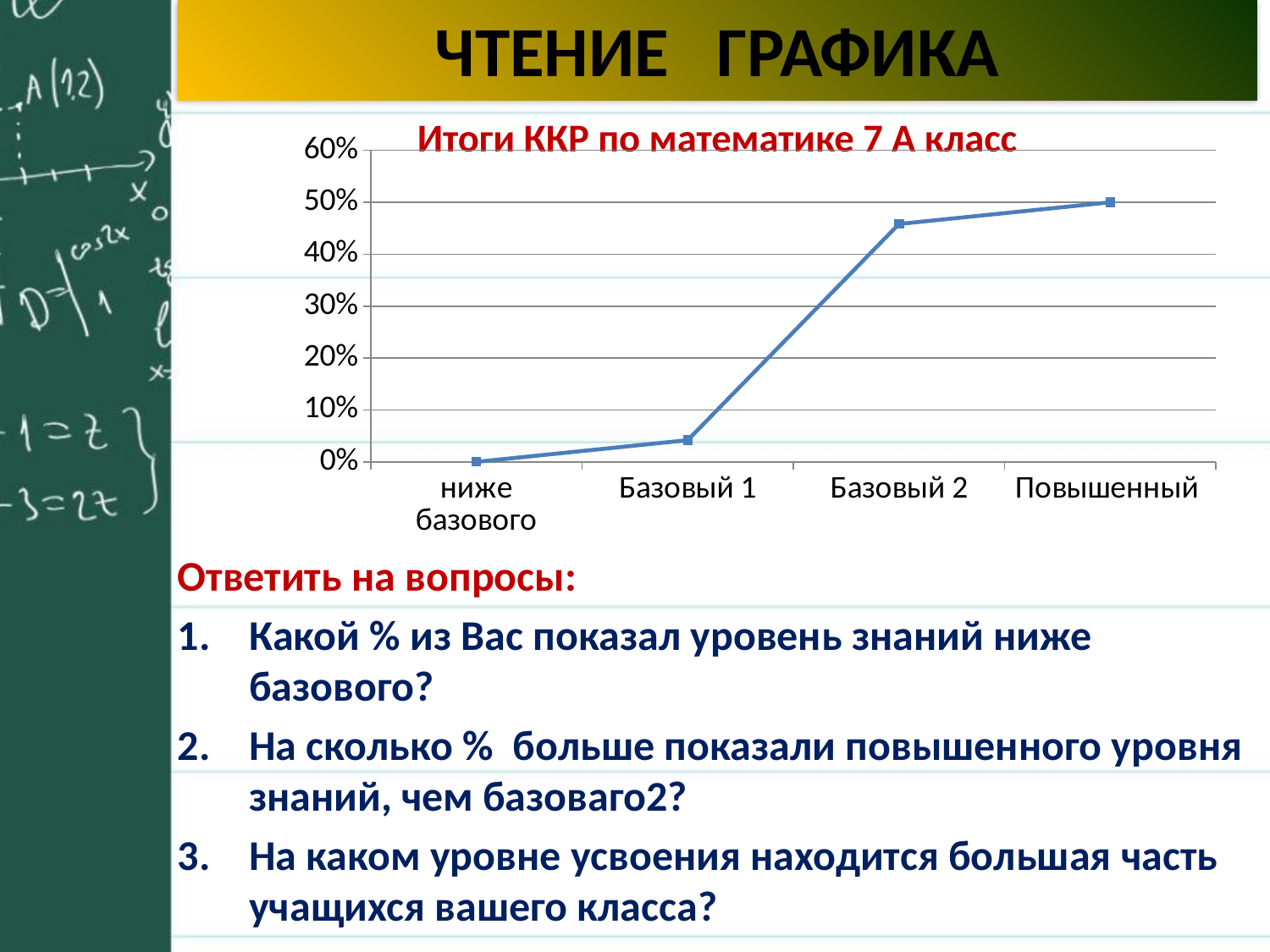
What is the value for 'Повышенный'? 50% What is the value for 'ниже базового'? 0% Which category has the lowest value? ниже базового Is the value for 'Базовый 2' greater or less than 40%? greater Which category has the highest value? Повышенный What is the title of the chart? Итоги ККР по математике 7 А класс How many categories are shown on the x axis of the chart? 4 Is the value for 'Базовый 1' greater or less than 10%? less Which is larger, the value for 'Базовый 1' or the value for 'Базовый 2'? Базовый 2 What type of chart is shown on the slide? line chart Do the values rise or fall from left to right along the x axis? rise Is the value for 'Базовый 2' greater or less than 50%? less